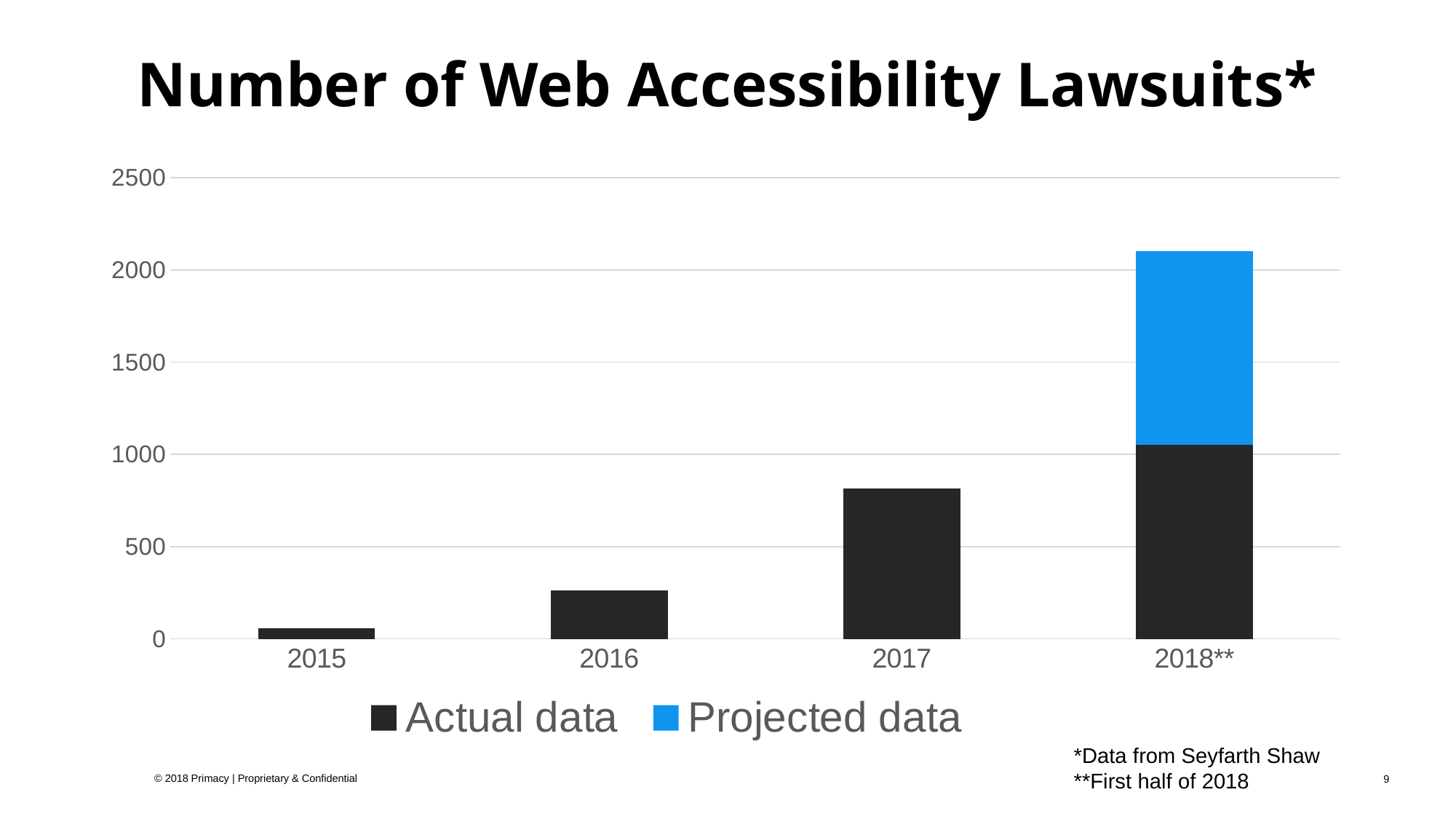
How many years are shown on the x axis? 4 Which year has the tallest bar? 2018** Is the Actual data value for 2016 greater or less than 500? less Is the Actual data value for 2018** greater or less than 1000? greater Is the total height of the 2018** bar greater or less than 2000? greater Do the values rise or fall from 2015 to 2018**? rise How many series does the legend list? 2 What is the title of the chart? Number of Web Accessibility Lawsuits* Which year has the lowest number of lawsuits? 2015 What kind of chart is shown on the slide? bar chart Which year has more lawsuits, 2016 or 2017? 2017